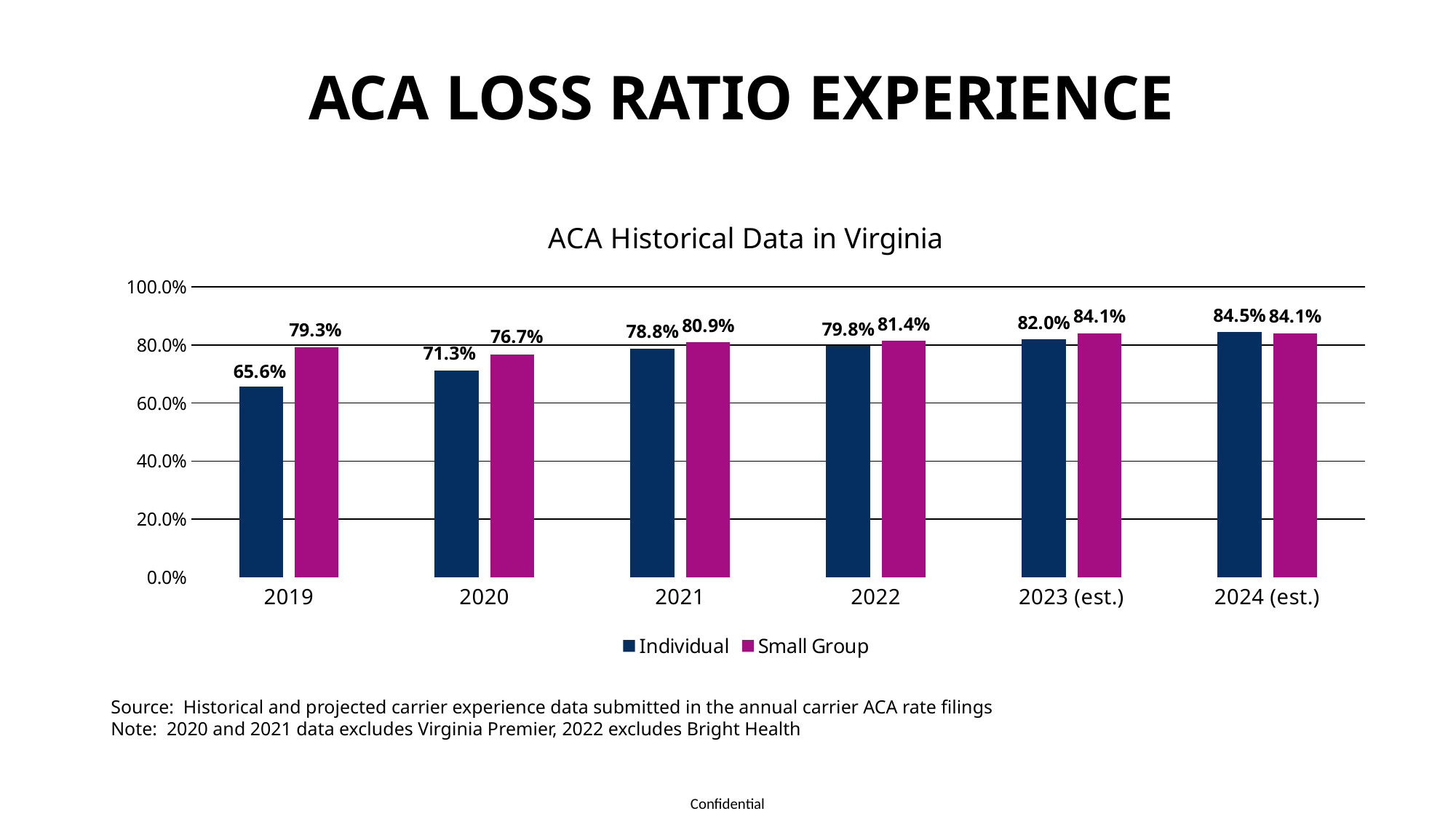
Which year has the lowest Individual loss ratio? 2019 What kind of chart is shown on the slide? Bar chart Which year has the highest Small Group loss ratio? 2023 (est.) and 2024 (est.) Does the Individual loss ratio rise or fall from 2019 to 2024 (est.)? Rise What is the Individual loss ratio for 2019? 65.6% How many years are shown on the x axis? 6 What is the Individual loss ratio for 2024 (est.)? 84.5% Is the Individual loss ratio for 2020 greater or less than 80.0%? less What is the Small Group loss ratio for 2021? 80.9% In 2024 (est.), which is larger, the Individual or the Small Group loss ratio? Individual How many series does the legend list? 2 What is the difference between the Small Group and Individual loss ratios in 2019? 13.7%